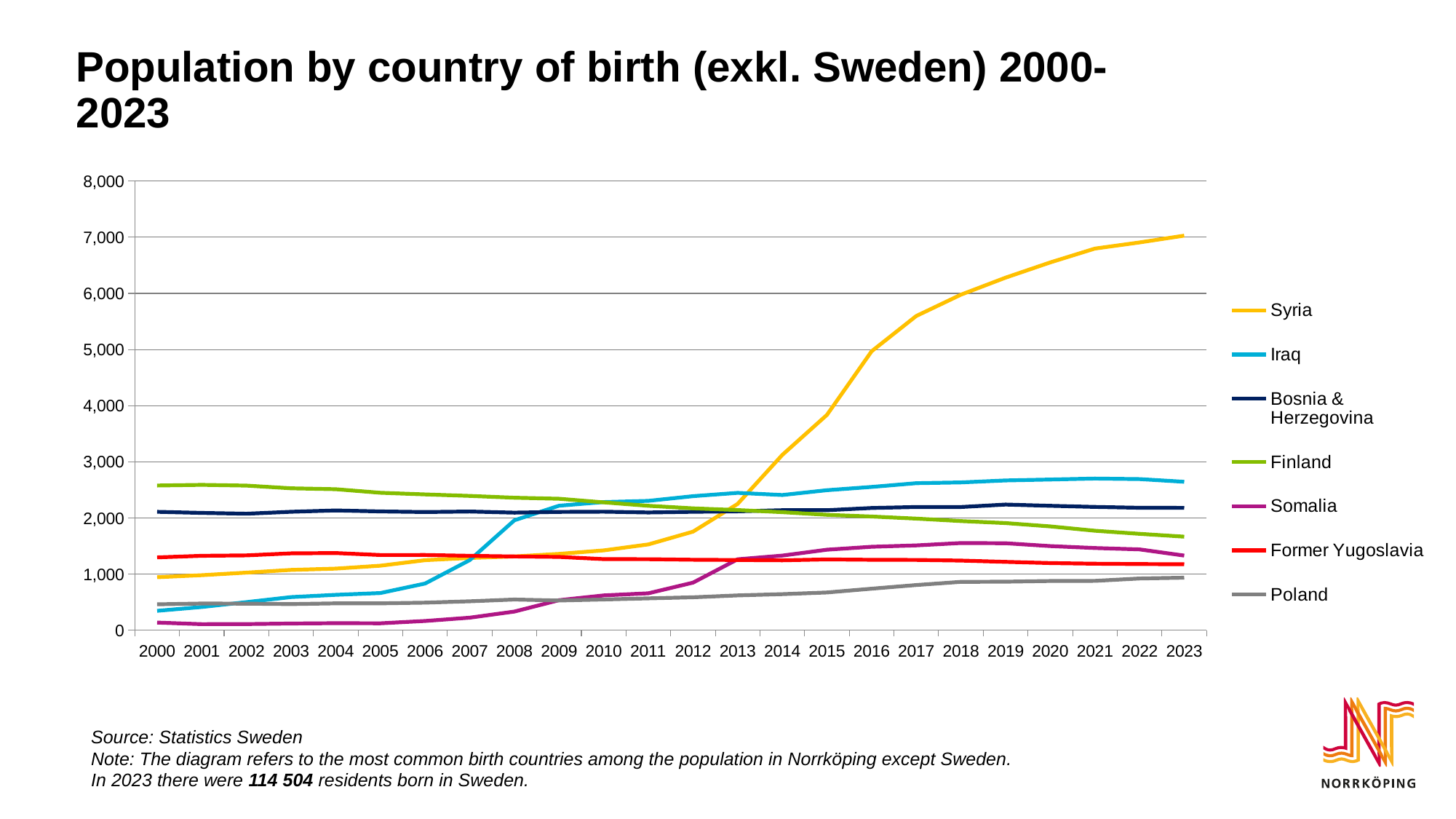
Is the value for Syria in 2023 greater or less than 6,000? greater Does the Finland line rise or fall from 2000 to 2023? fall Which country has the highest population in 2023? Syria Which country has the lowest population in 2023? Poland How many series does the legend list? 7 Which country has the highest population in 2000? Finland In 2023, which is larger: the value for Somalia or the value for Poland? Somalia Does the Syria line rise or fall from 2000 to 2023? rise Which country has the lowest population in 2000? Somalia Is the value for Iraq in 2023 greater or less than 3,000? less How many years are plotted along the x axis? 24 What kind of chart is shown on the slide? line chart